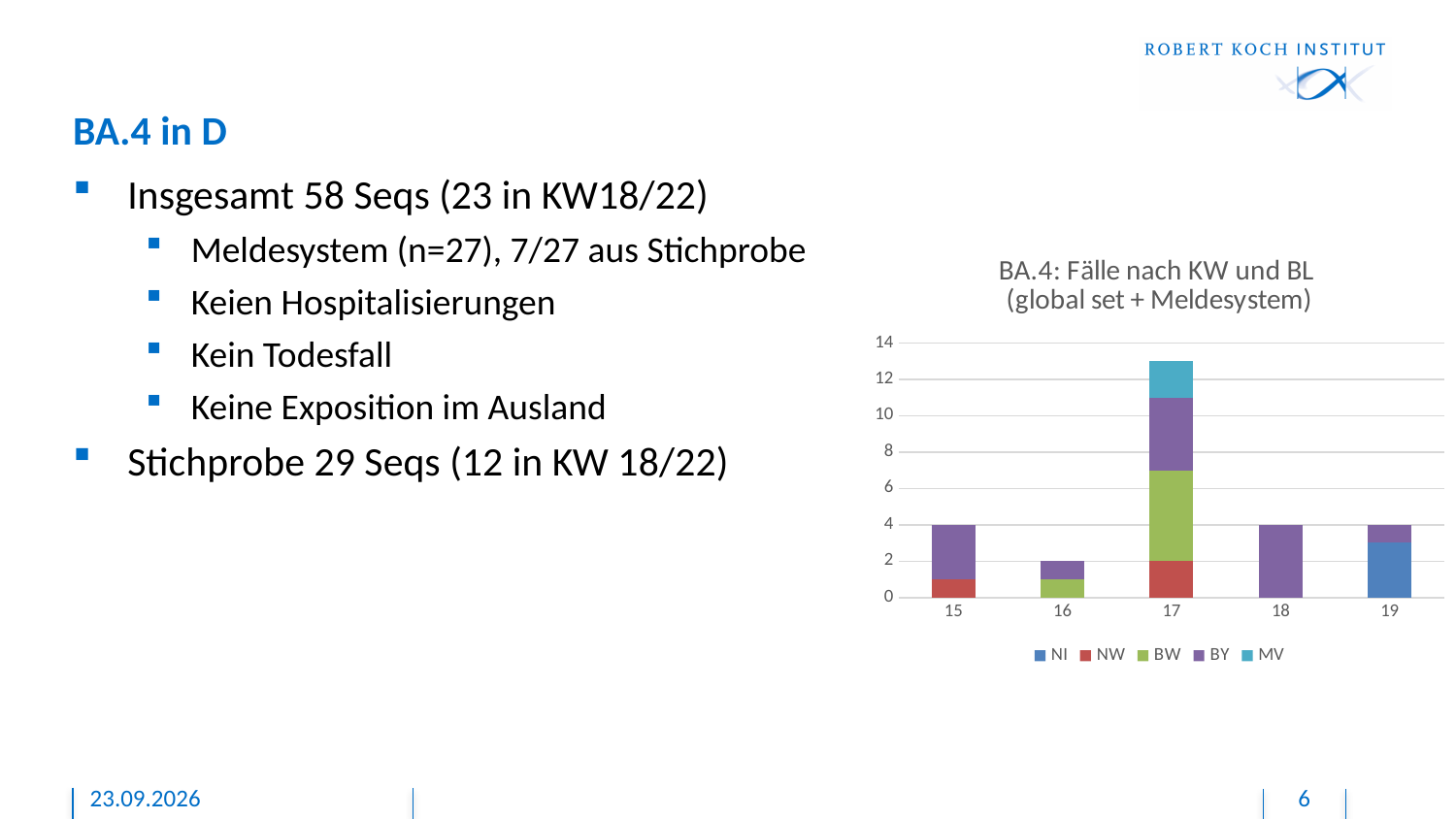
Which series are listed in the chart legend? NI, NW, BW, BY, MV Which calendar week has the lowest total number of cases? 16 What is the total height of the stacked bar for week 16? 2 What kind of chart is shown on the slide? stacked bar chart Which has a larger total, week 17 or week 18? 17 How many calendar weeks (categories) are shown on the x axis? 5 What is the title of the chart? BA.4: Fälle nach KW und BL (global set + Meldesystem) Is the total for week 17 greater or less than 12? greater How many series does the chart legend list? 5 What is the value for BY in week 18? 4 What is the total height of the stacked bar for week 15? 4 Which calendar week has the highest total number of cases? 17